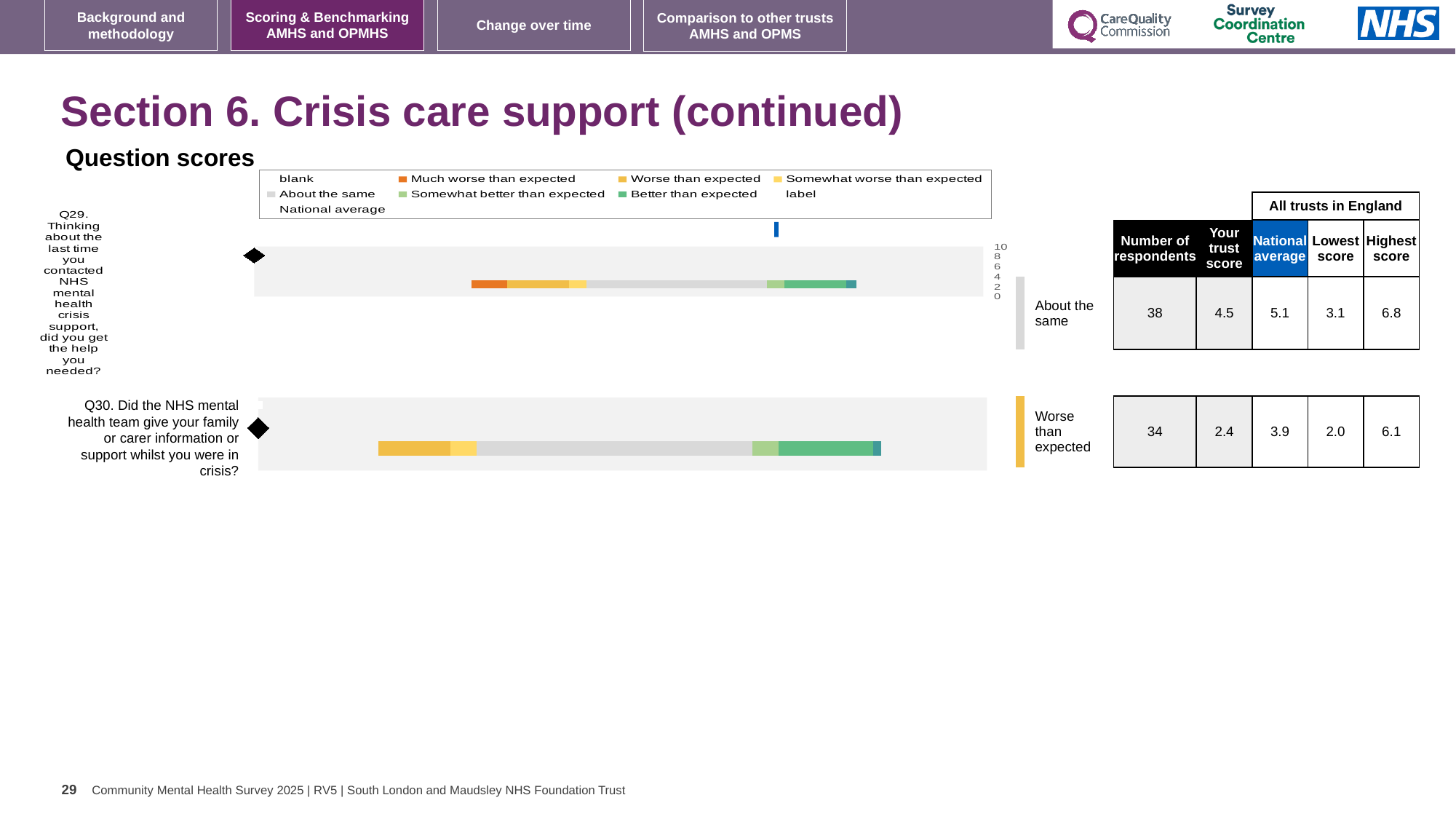
What is the highest tick value shown on the score axis of the question scores chart? 10 In the question scores chart, which segment is the widest in the Q30 bar? About the same What kind of chart is used to show the question scores for Q29 and Q30? Stacked bar chart What rating label is shown next to the Q30 bar in the question scores chart? Worse than expected According to the table beside the chart, which is larger for Q29: the trust score or the national average? National average What rating label is shown next to the Q29 bar in the question scores chart? About the same Which legend entry is shown in grey in the question scores chart? About the same How many questions (bars) are plotted in the question scores chart? 2 According to the table beside the chart, what is the trust score for Q29? 4.5 According to the table beside the chart, what is the national average for Q30? 3.9 In the question scores chart, which segment is the widest in the Q29 bar? About the same Which legend entry is shown in orange in the question scores chart? Much worse than expected